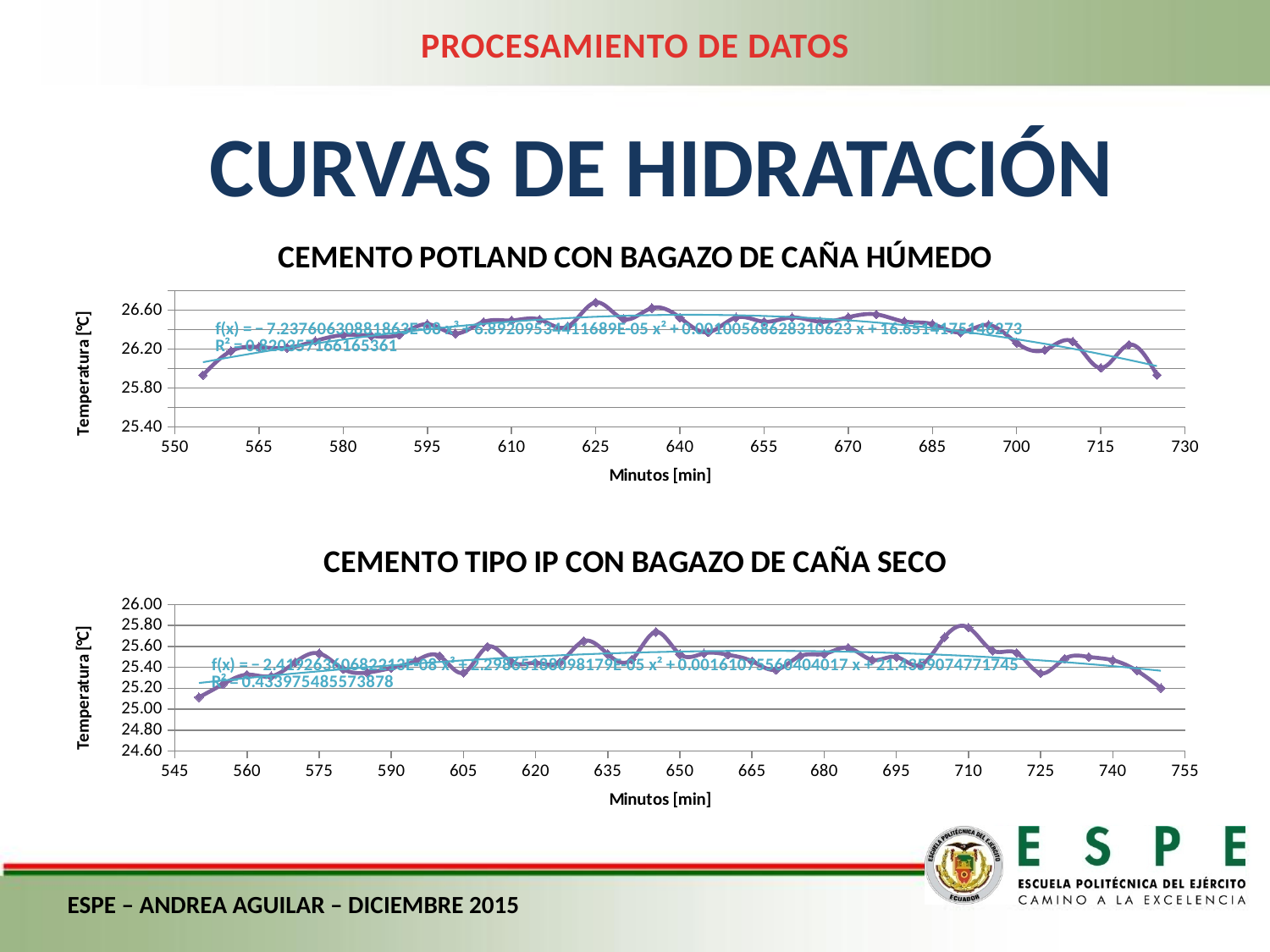
In the top chart, is the temperature at the first plotted point (around 555 minutes) greater or less than 26.20? less What is the title of the bottom chart on the slide? CEMENTO TIPO IP CON BAGAZO DE CAÑA SECO In the top chart, is the temperature at around 625 minutes greater or less than 26.20? greater In the top chart, does the temperature rise or fall between about 555 and 625 minutes? rise In the top chart, which is higher: the temperature at around 625 minutes or at around 725 minutes? around 625 minutes In the bottom chart, is the temperature at the first plotted point (around 550 minutes) greater or less than 25.40? less What is the x-axis label of the top chart? Minutos [min] In the bottom chart, does the temperature rise or fall between about 550 and 575 minutes? rise In the bottom chart, which is higher: the temperature at around 710 minutes or at around 550 minutes? around 710 minutes What kind of chart is the top chart, 'CEMENTO POTLAND CON BAGAZO DE CAÑA HÚMEDO'? Line chart In the top chart, does the temperature rise or fall between about 700 and 725 minutes? fall